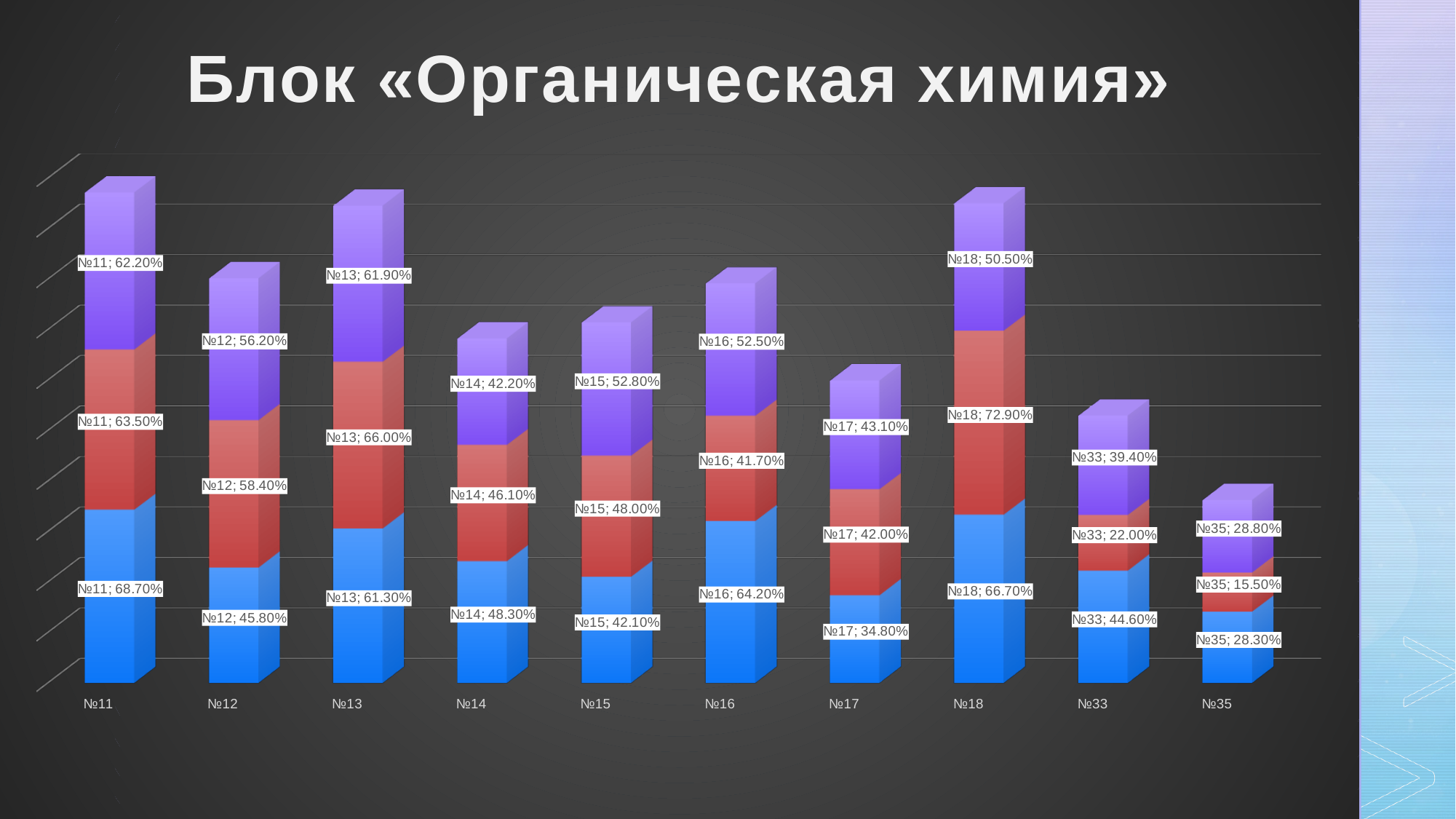
What kind of chart is shown on the slide? Stacked bar chart Which has the larger bottom (blue) segment value, №16 or №17? №16 What is the value of the bottom (blue) segment for №35? 28.30% Which category has the shortest stacked bar overall? №35 How many segments (series) does each stacked bar consist of? 3 How many categories are shown on the x axis? 10 What is the value of the bottom (blue) segment for №11? 68.70% What is the value of the middle (red) segment for №18? 72.90% What is the difference between the middle (red) segment values of №13 and №14? 19.90% What is the total of the three segments for №35? 72.60% What is the value of the top (purple) segment for №33? 39.40% Which category has the highest middle (red) segment value? №18